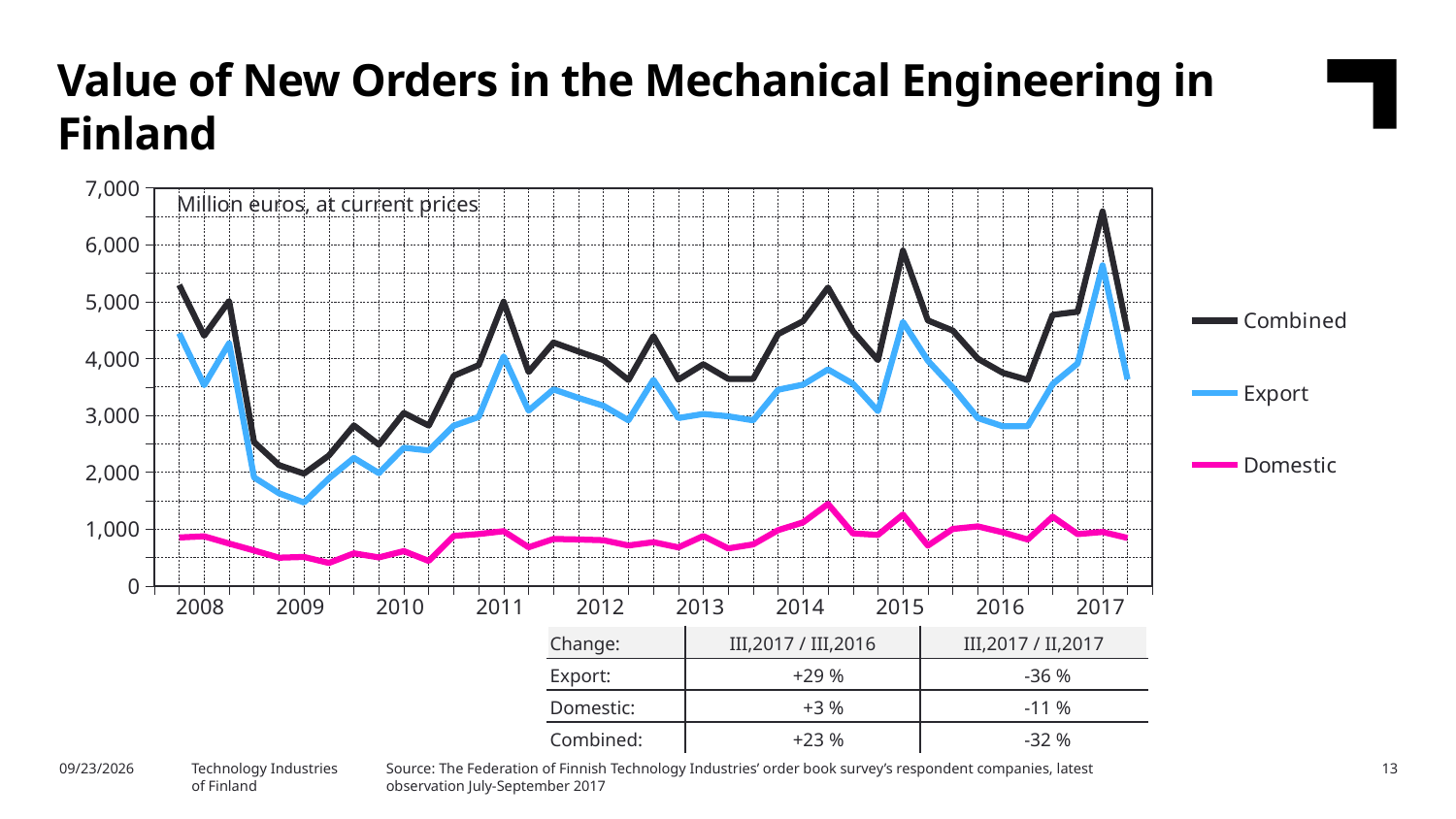
Which series has the lowest values throughout the period? Domestic How many series does the legend list? 3 What kind of chart is shown on the slide? Line chart Is the peak value of the Combined series in 2017 greater or less than 6,000? greater Which series are listed in the legend? Combined, Export, Domestic Does the Combined series rise or fall from the start of 2008 to 2009? Fall Is the lowest value of the Export series in 2009 greater or less than 2,000? less In which year does the Combined series reach its highest value? 2017 What unit note is printed inside the chart area? Million euros, at current prices Is the peak value of the Export series in 2017 greater or less than 5,000? greater How many years are labelled on the x axis? 10